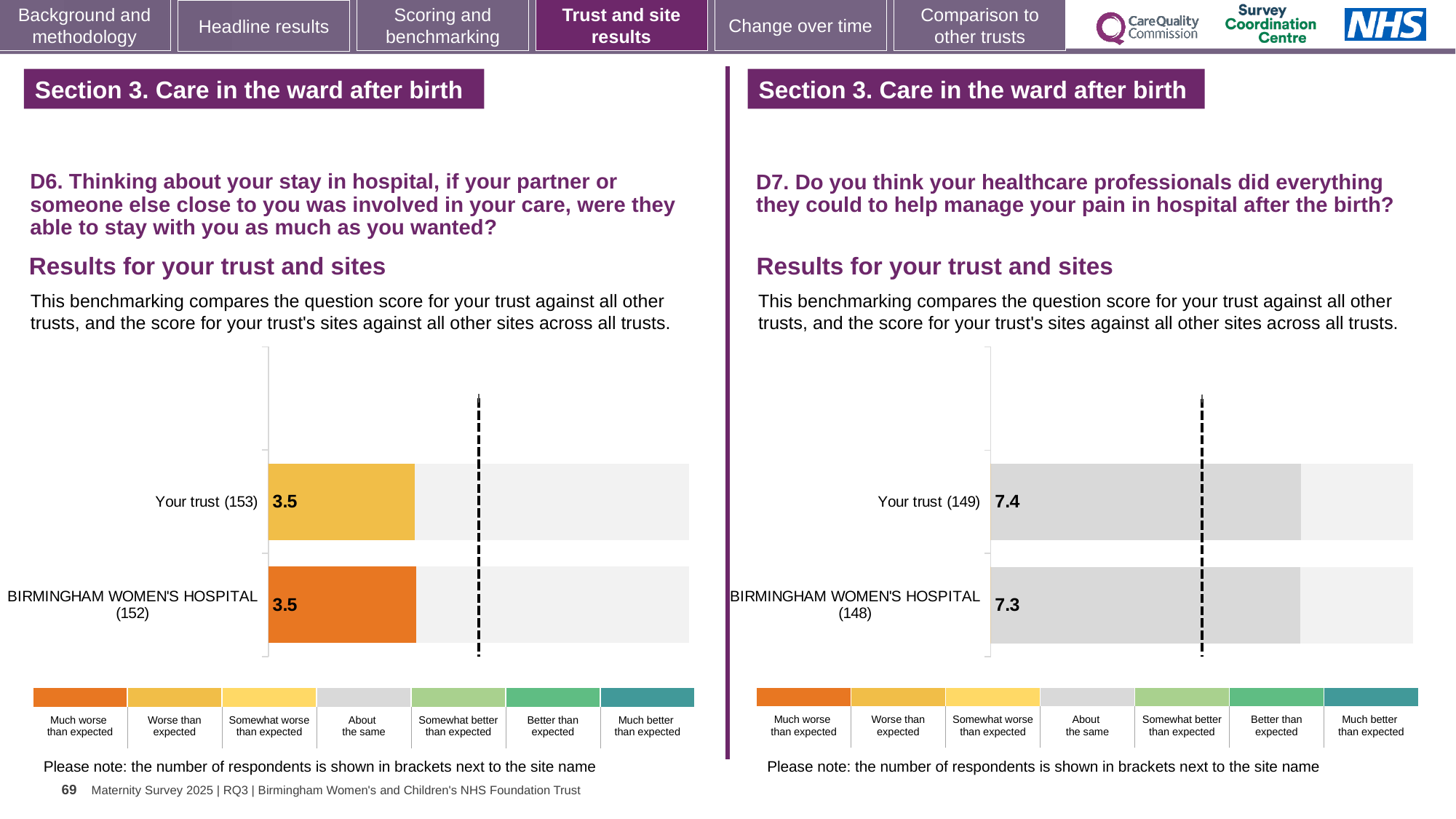
In the D6 chart on the left, how many respondents are shown in brackets for Birmingham Women's Hospital? 152 What type of chart is used for the D7 results on the right? Bar chart In the D7 chart on the right, which benchmark category does the colour of the Your trust bar correspond to? About the same How many bars are plotted in the D6 chart on the left? 2 In the D6 chart on the left, what is the score for Birmingham Women's Hospital? 3.5 In the D7 chart on the right, which has the higher score, Your trust or Birmingham Women's Hospital? Your trust In the D7 chart on the right, what is the score for Your trust? 7.4 In the D7 chart on the right, what is the difference between the score for Your trust and the score for Birmingham Women's Hospital? 0.1 In the D7 chart on the right, what is the score for Birmingham Women's Hospital? 7.3 In the D6 chart on the left, what is the difference between the score for Your trust and the score for Birmingham Women's Hospital? 0 In the D6 chart on the left, what is the score for Your trust? 3.5